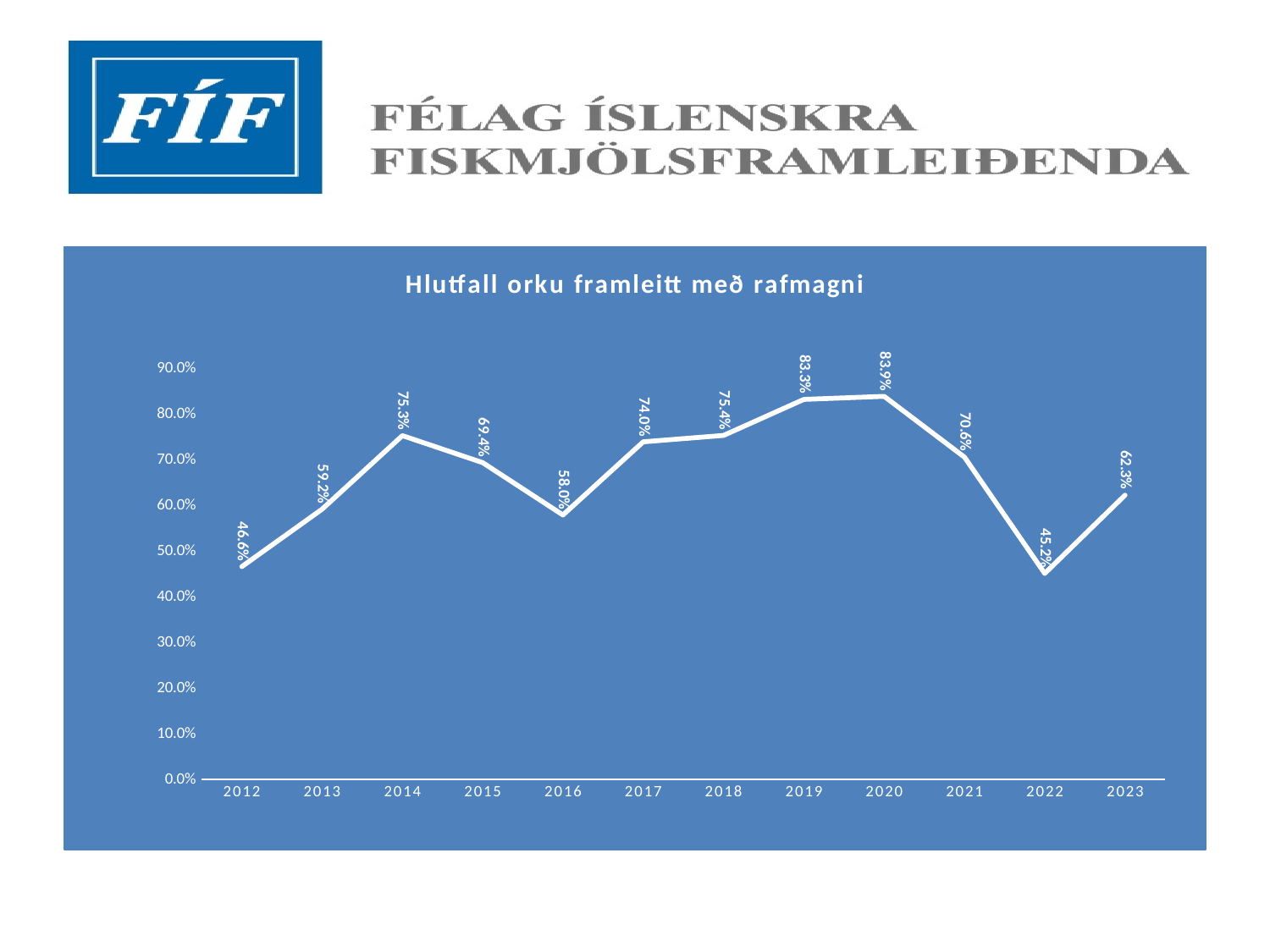
What is the title of the chart? Hlutfall orku framleitt með rafmagni Which year has the highest value? 2020 What kind of chart is this? line chart What is the value for 2023? 62.3% How many years are shown on the x axis? 12 Is the value for 2021 greater or less than 60.0%? greater Do the values rise or fall from 2020 to 2022? fall What is the value for 2019? 83.3% Which is larger, the value for 2017 or the value for 2016? 2017 What is the difference between the values for 2014 and 2013? 16.1% Which year has the lowest value? 2022 What is the value for 2012? 46.6%